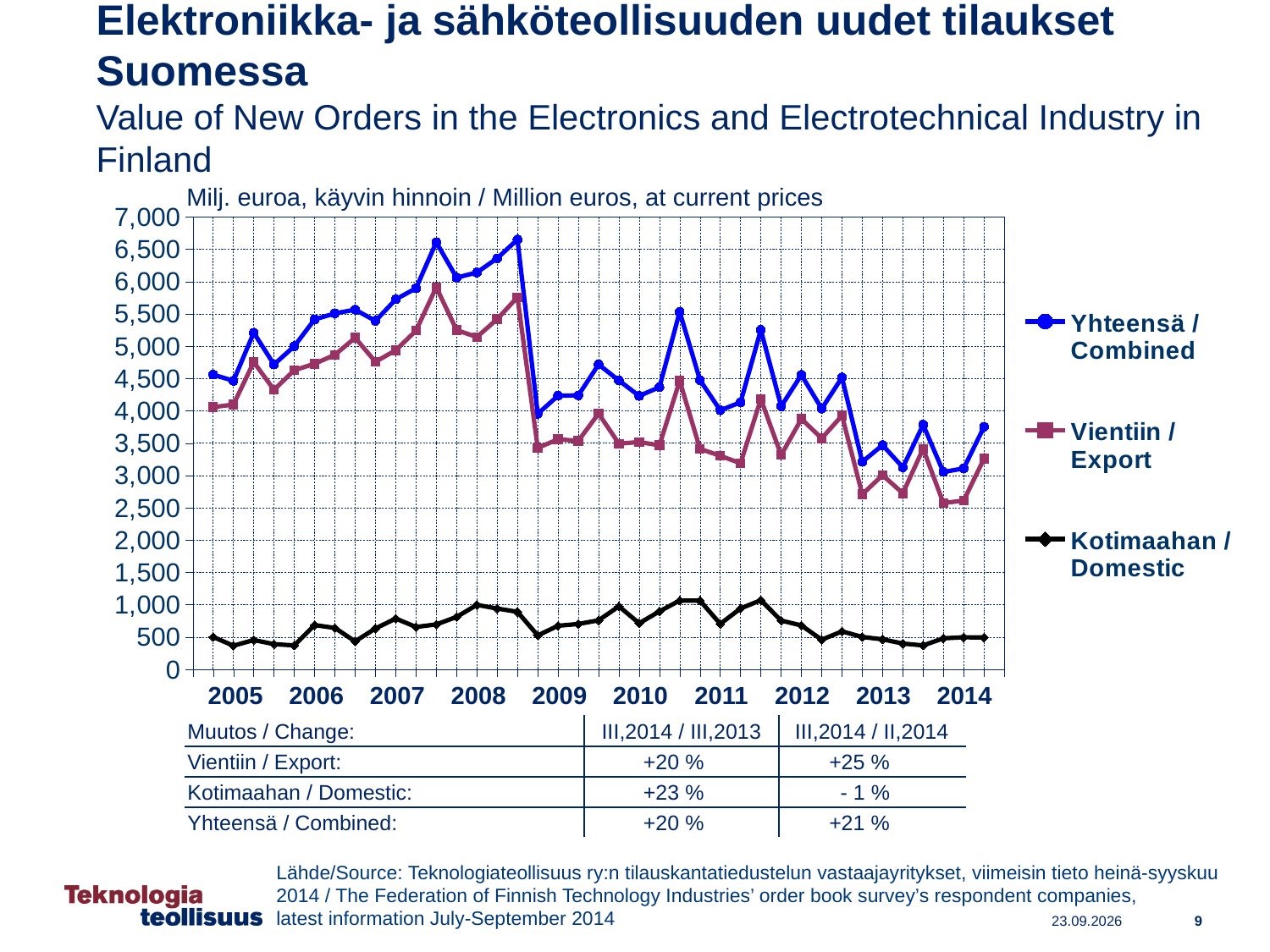
What unit is stated above the chart for the plotted values? Milj. euroa, käyvin hinnoin / Million euros, at current prices How many years are labelled on the x axis of the chart? 10 Is the value of the Kotimaahan / Domestic series at the start of 2005 greater or less than 1,000? less How many series does the chart legend list? 3 Does the Vientiin / Export series generally rise or fall from 2011 to 2013? fall Is the peak value of the Yhteensä / Combined series in 2008 greater or less than 6,000? greater Which series is larger in 2012, Vientiin / Export or Kotimaahan / Domestic? Vientiin / Export Is the lowest value of the Vientiin / Export series in 2014 greater or less than 3,000? less Which series has the lowest values throughout the chart? Kotimaahan / Domestic Does the Yhteensä / Combined series generally rise or fall from 2005 to 2008? rise What kind of chart is shown on the slide? line chart Which series has the highest values throughout the chart? Yhteensä / Combined